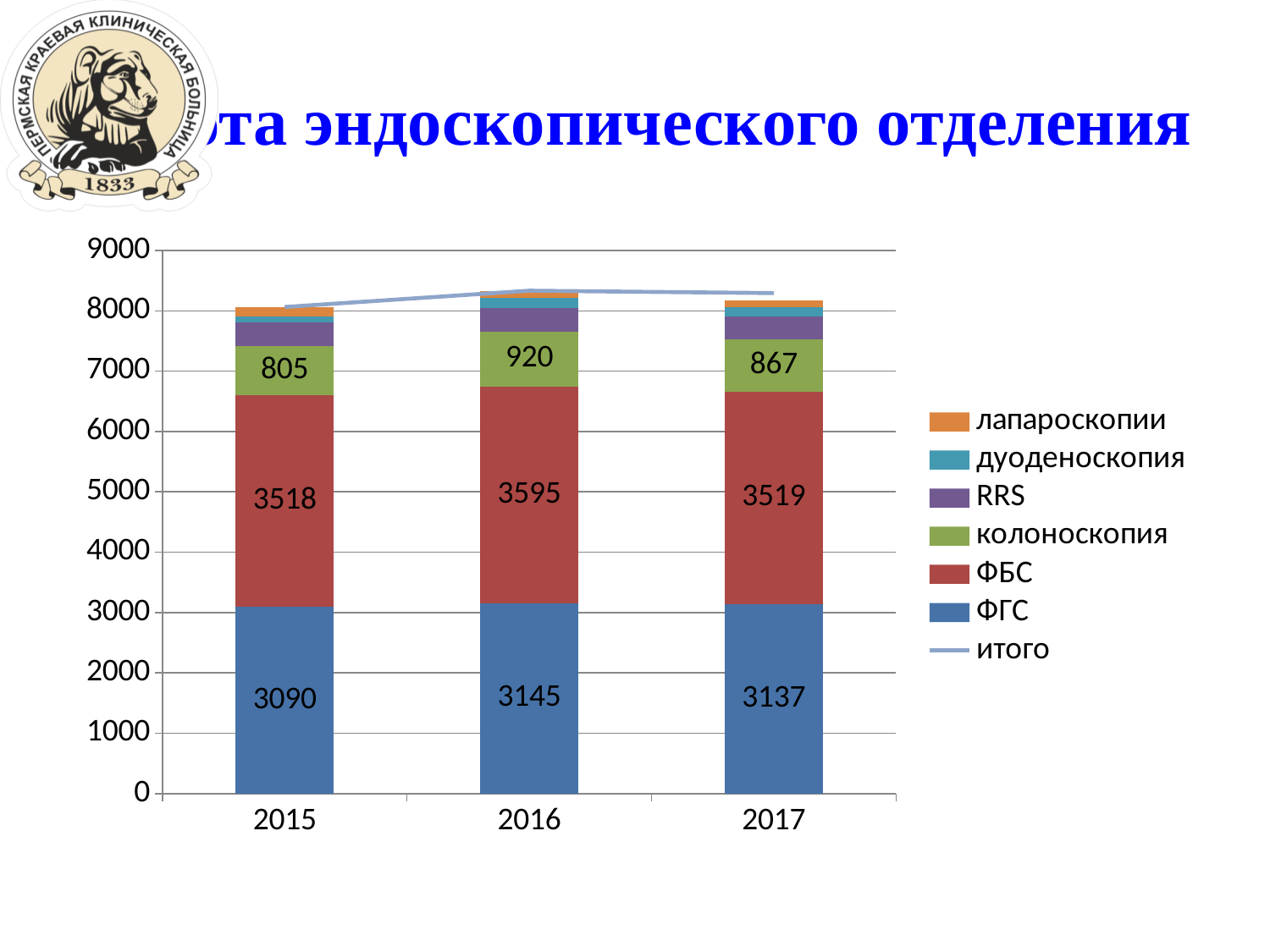
How many entries does the legend list? 7 Is the total height of the stacked bar for 2016 greater or less than 8000? greater In which year is the value for колоноскопия highest? 2016 What is the value for колоноскопия in 2017? 867 What is the difference between the ФБС values for 2016 and 2015? 77 In which year is the value for ФГС lowest? 2015 Which is larger, the ФГС value for 2017 or for 2015? 2017 What is the value for ФГС in 2016? 3145 What is the difference between the колоноскопия values for 2016 and 2017? 53 How many years are shown on the x axis? 3 What is the value for ФБС in 2015? 3518 What kind of chart is shown on the slide? stacked bar chart with a line